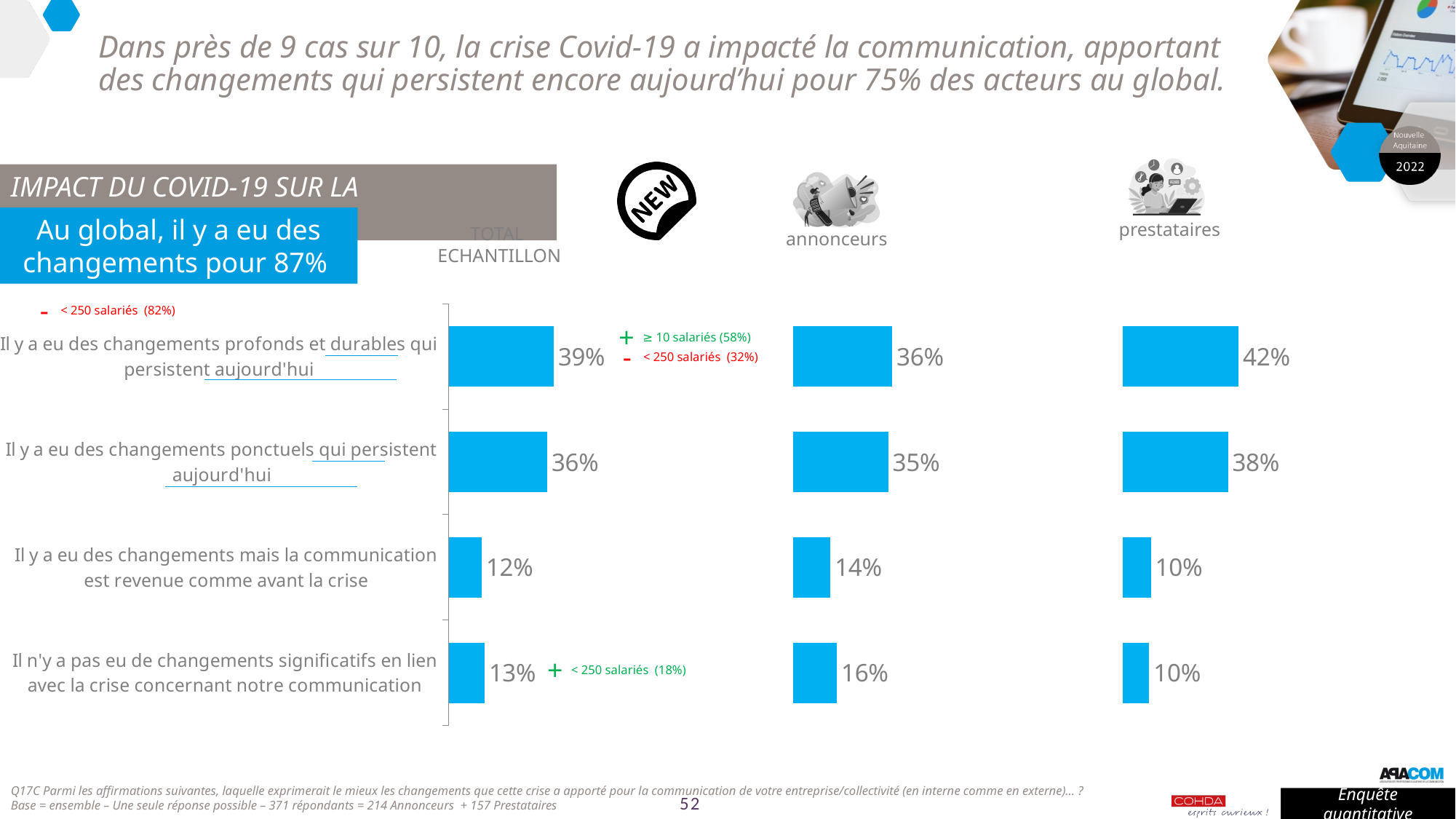
In the annonceurs chart, what is the difference between the values for "changements profonds et durables" and "changements ponctuels"? 1% In the prestataires chart, what is the value for "Il y a eu des changements mais la communication est revenue comme avant la crise"? 10% In the TOTAL ECHANTILLON chart, what is the difference between the values for "changements profonds et durables" and "Il n'y a pas eu de changements significatifs"? 26% What kind of chart is used for the annonceurs data? bar chart How many categories does the TOTAL ECHANTILLON chart show? 4 In the annonceurs chart, what is the value for "Il y a eu des changements ponctuels qui persistent aujourd'hui"? 35% Which is larger: the value for "changements profonds et durables" in the annonceurs chart or in the prestataires chart? prestataires In the TOTAL ECHANTILLON chart, which category has the lowest value? Il y a eu des changements mais la communication est revenue comme avant la crise What colour are the bars in the prestataires chart? blue In the prestataires chart, which category has the highest value? Il y a eu des changements profonds et durables qui persistent aujourd'hui In the TOTAL ECHANTILLON chart, what is the value for "Il y a eu des changements profonds et durables qui persistent aujourd'hui"? 39% In the annonceurs chart, what is the value for "Il n'y a pas eu de changements significatifs en lien avec la crise concernant notre communication"? 16%